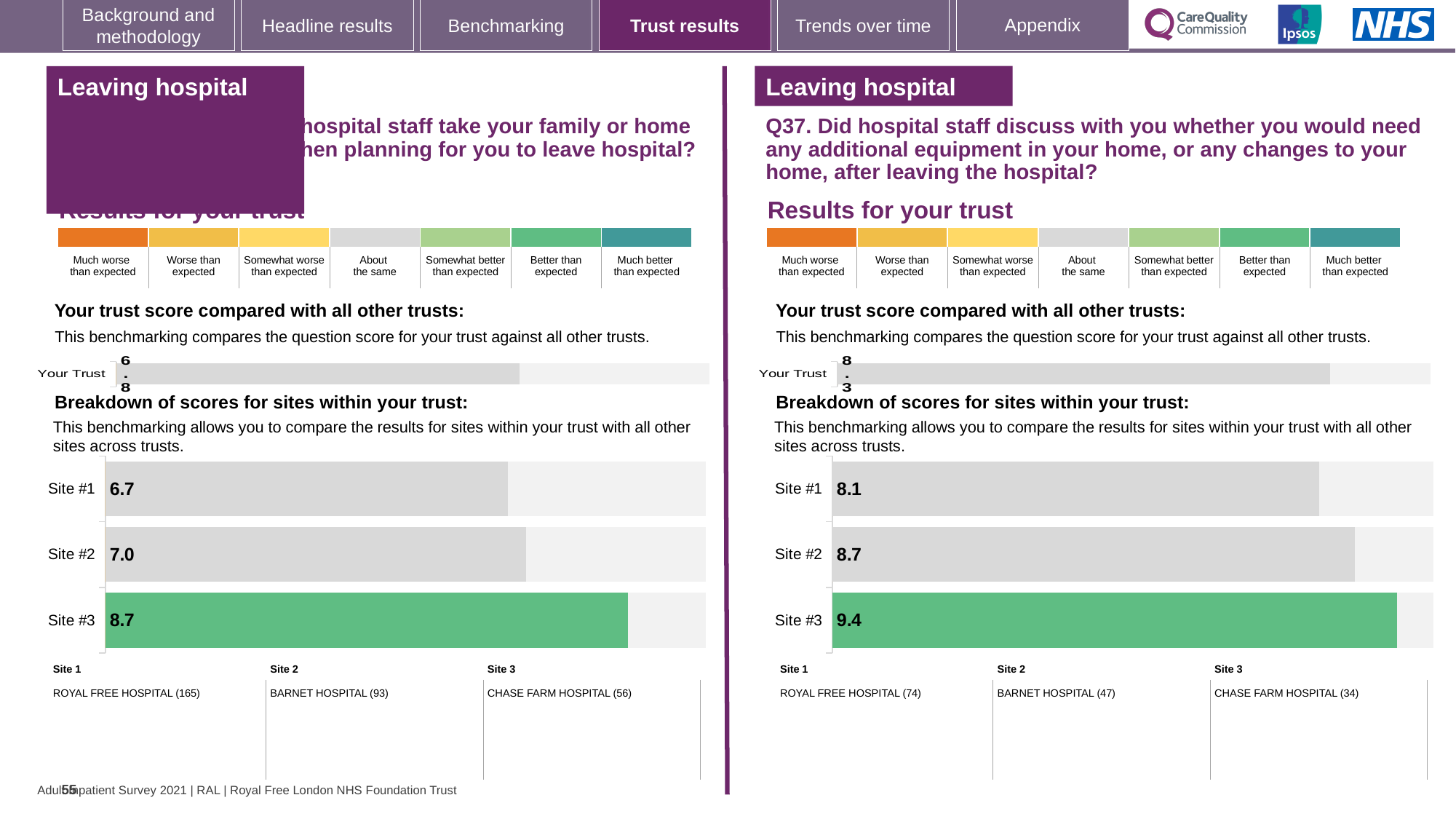
On the left-hand site breakdown chart, what is the difference between the scores for Site #3 and Site #1? 2.0 On the left-hand site breakdown chart, which is larger: the score for Site #2 or Site #1? Site #2 How many sites are shown on the right-hand (Q37) site breakdown chart? 3 On the left-hand site breakdown chart, which site has the highest score? Site #3 On the left-hand site breakdown chart, what is the score for Site #1? 6.7 On the left-hand site breakdown chart, what is the score for Site #3? 8.7 On the right-hand (Q37) site breakdown chart, what is the difference between the scores for Site #3 and Site #2? 0.7 On the right-hand (Q37) site breakdown chart, what is the score for Site #2? 8.7 What type of chart is used for the site breakdown on the left-hand side of the slide? Bar chart On the right-hand (Q37) site breakdown chart, which site has the lowest score? Site #1 On the right-hand (Q37) 'Your Trust' chart, what is the trust score? 8.3 On the right-hand (Q37) site breakdown chart, what is the score for Site #3? 9.4